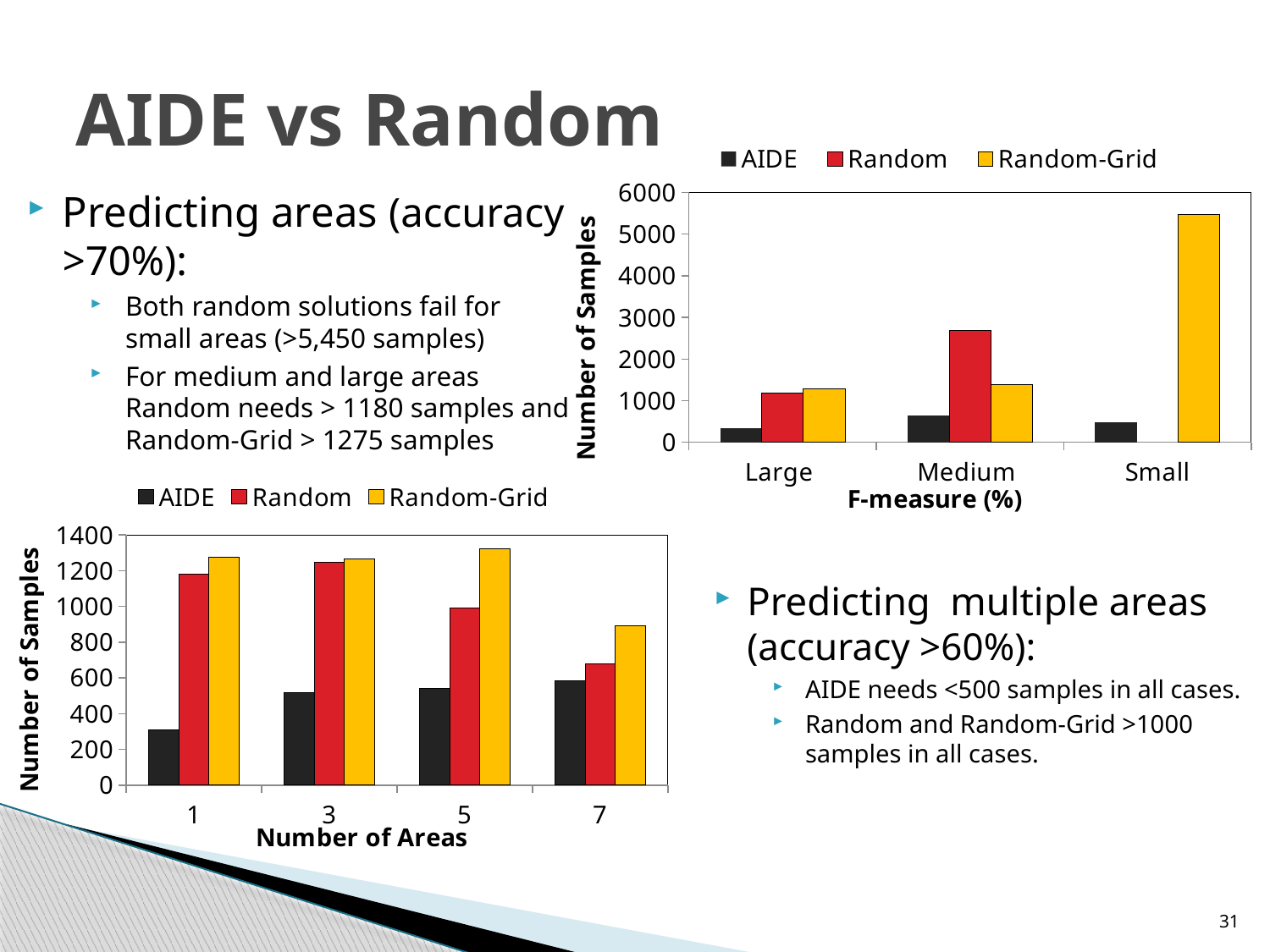
In the bottom-left chart, which category has the lowest Random-Grid value? 7 What kind of chart is the chart in the top right of the slide? bar chart How many categories are shown on the x axis of the top-right chart? 3 In the top-right chart, is the Random value for Medium greater or less than 2000? greater In the top-right chart, which is larger for Medium: the Random value or the Random-Grid value? Random What is the x-axis title of the top-right chart? F-measure (%) In the top-right chart, is the Random-Grid value for Small greater or less than 5000? greater How many categories are shown on the x axis of the bottom-left chart? 4 How many series does the legend of the bottom-left chart list? 3 In the bottom-left chart, do the AIDE values rise or fall as the number of areas increases from 1 to 7? rise In the bottom-left chart, is the AIDE value for 1 area greater or less than 400? less In the top-right chart, which category has the highest Random-Grid value? Small